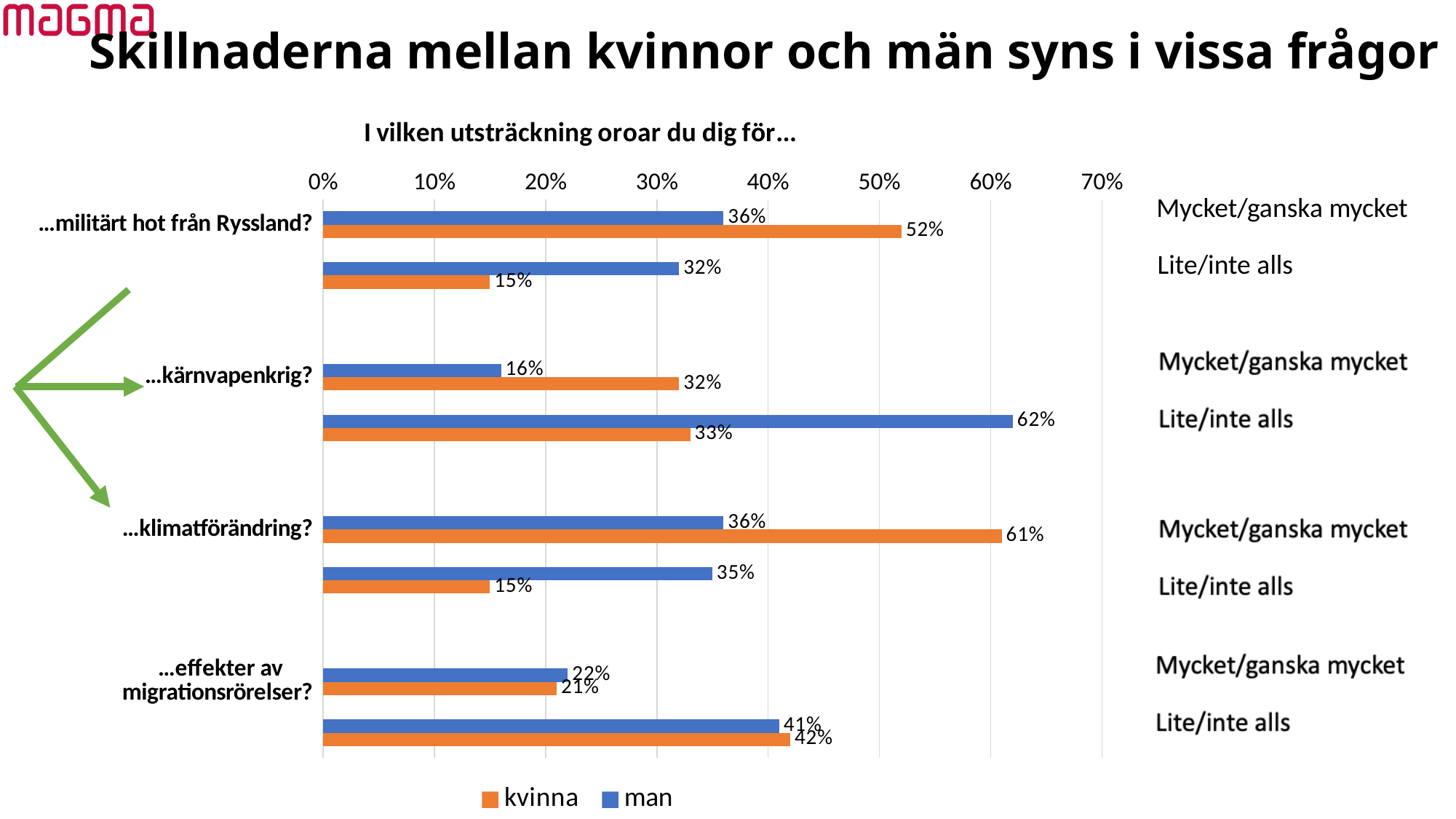
What is the difference between men and women answering 'Lite/inte alls' for '...kärnvapenkrig?' 29% What is the difference between women and men answering 'Mycket/ganska mycket' for '...klimatförändring?' 25% For '...militärt hot från Ryssland?' 'Mycket/ganska mycket', which group has the higher value, kvinna or man? kvinna What kind of chart is shown on the slide? bar chart Which bar in the chart has the highest value? man, Lite/inte alls, ...kärnvapenkrig? (62%) What percentage of women (kvinna) answered 'Mycket/ganska mycket' for '...militärt hot från Ryssland?' 52% What percentage of women (kvinna) answered 'Mycket/ganska mycket' for '...klimatförändring?' 61% What percentage of men (man) answered 'Lite/inte alls' for '...kärnvapenkrig?' 62% What percentage of men (man) answered 'Mycket/ganska mycket' for '...effekter av migrationsrörelser?' 22% For '...kärnvapenkrig?' 'Mycket/ganska mycket', which group has the higher value, kvinna or man? kvinna How many series does the legend list? 2 Which colour represents the 'man' series in the chart? blue